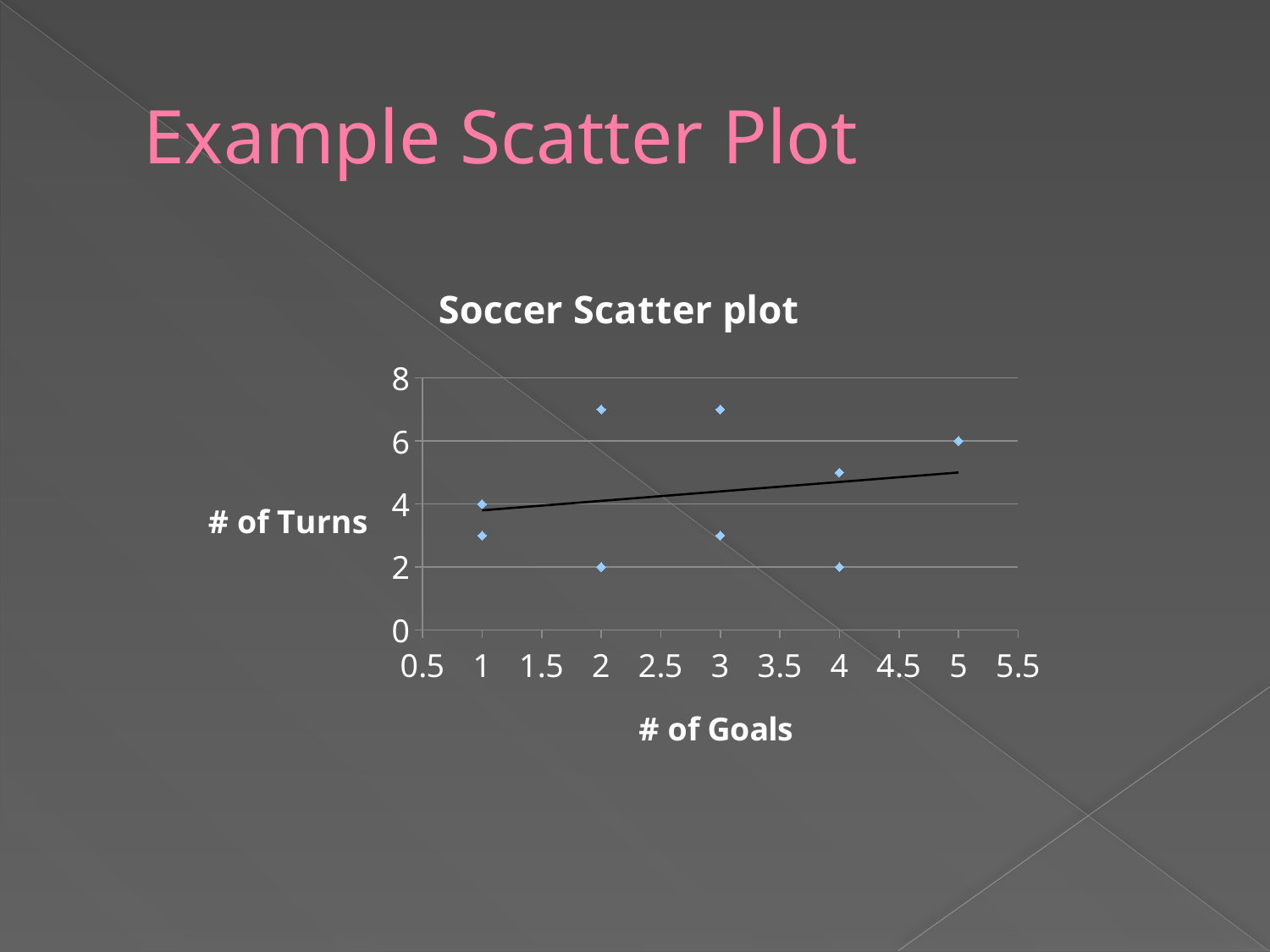
What is the # of Turns for the lower of the two points at 4 goals? 2 How many data points are plotted on the chart? 9 Does the trend line rise or fall as # of Goals increases? Rises What kind of chart is shown on the slide? Scatter plot What is the # of Turns for the point at 5 goals? 6 What is the label of the x axis? # of Goals What is the # of Turns for the lower of the two points at 2 goals? 2 What is the title of the chart? Soccer Scatter plot What is the # of Turns for the higher of the two points at 1 goal? 4 Is the # of Turns for the higher point at 3 goals greater or less than 6? greater Which is larger: the # of Turns for the point at 5 goals or the higher point at 4 goals? The point at 5 goals Is the # of Turns for the point at 5 goals greater or less than 4? greater